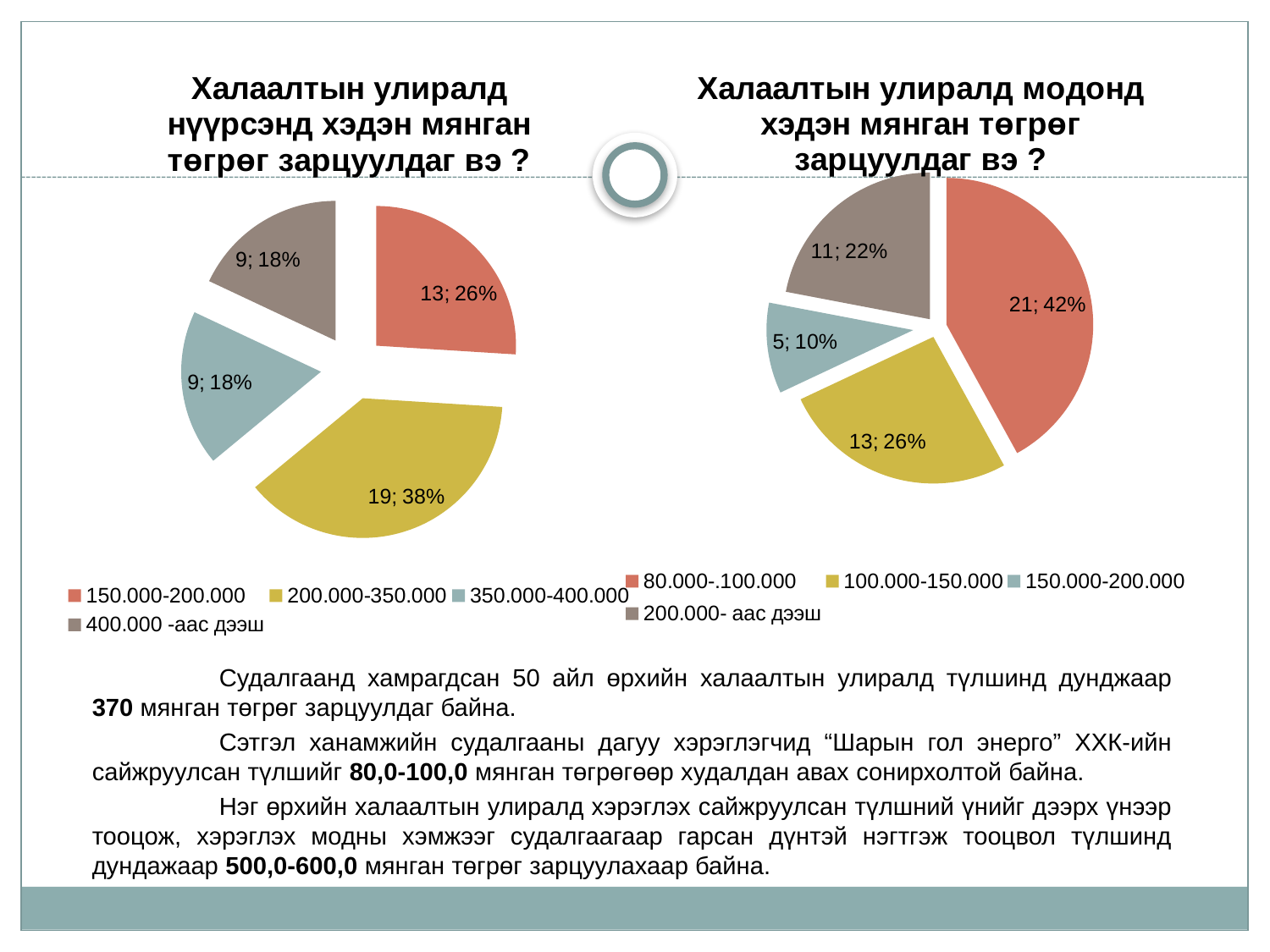
In the right chart (модонд), which is larger: the value for 100.000-150.000 or the value for 200.000- аас дээш? 100.000-150.000 How many categories does the legend of the right chart (модонд) list? 4 In the right chart (модонд), which category has the smallest slice? 150.000-200.000 In the right chart (модонд), what is the difference between the values for 80.000-.100.000 and 150.000-200.000? 16 In the left chart (нүүрсэнд), which category has the largest slice? 200.000-350.000 In the right chart (модонд), what share of the pie does the 200.000- аас дээш slice represent? 22% In the left chart (нүүрсэнд), what share of the pie does the 150.000-200.000 slice represent? 26% What type of chart is the left chart about coal spending (нүүрсэнд)? pie chart In the left chart (нүүрсэнд), what is the value for the 200.000-350.000 category? 19; 38% How many slices does the left chart (нүүрсэнд) have? 4 In the left chart (нүүрсэнд), what is the difference between the values for 200.000-350.000 and 150.000-200.000? 6 In the right chart (модонд), what is the value for the 80.000-.100.000 category? 21; 42%